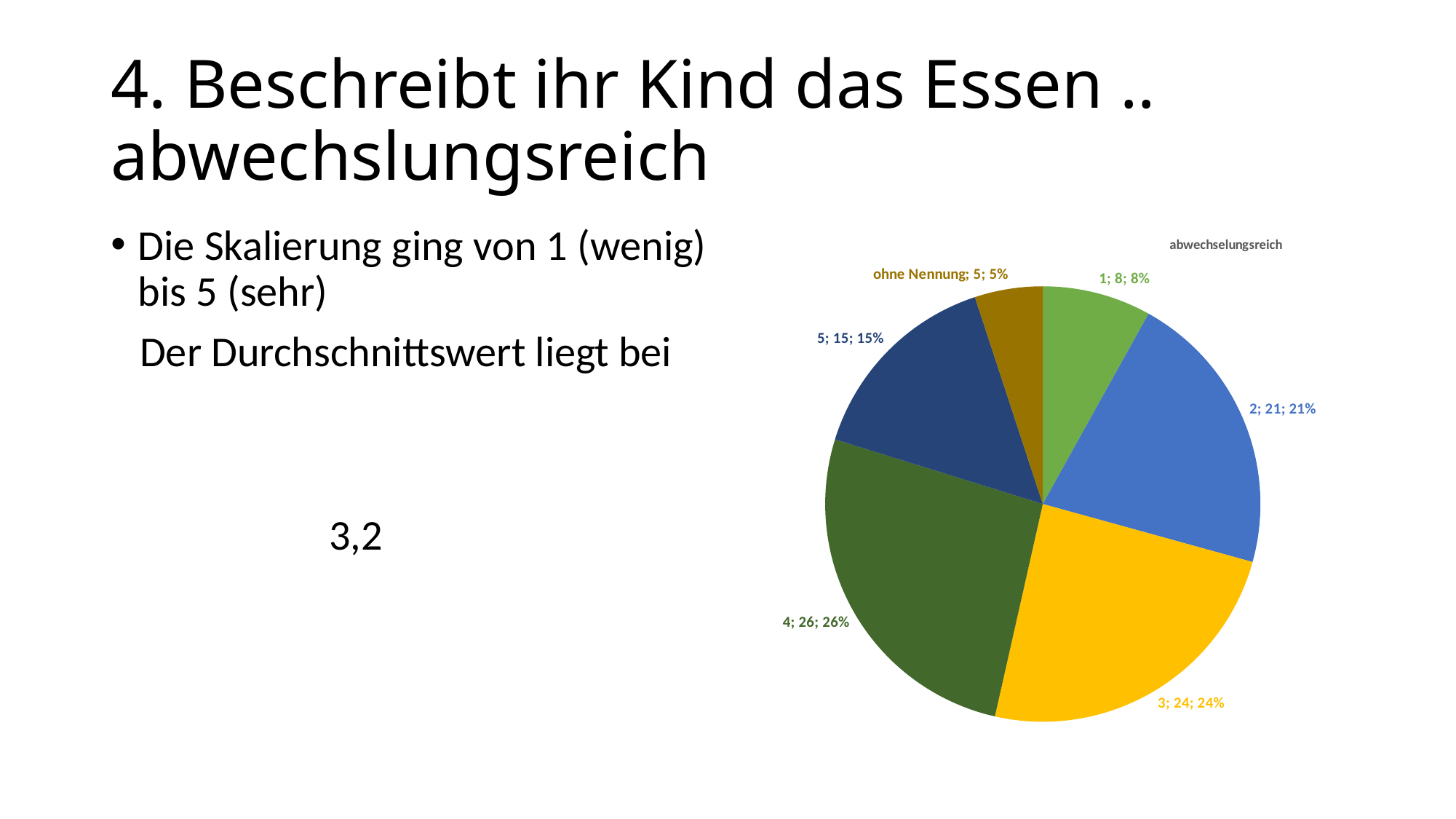
What is the difference between the values for category 4 and category 1? 18 What is the title of the chart? abwechselungsreich What is the value for category 3? 24 Which category has the smallest slice? ohne Nennung How many slices does the pie chart have? 6 What is the value for 'ohne Nennung'? 5 What kind of chart is shown on the slide? pie chart Which category has the largest slice? 4 What share of the pie does category 1 represent? 8% Which is larger, the value for category 2 or the value for category 5? 2 What share of the pie does category 2 represent? 21% What is the value for category 5? 15